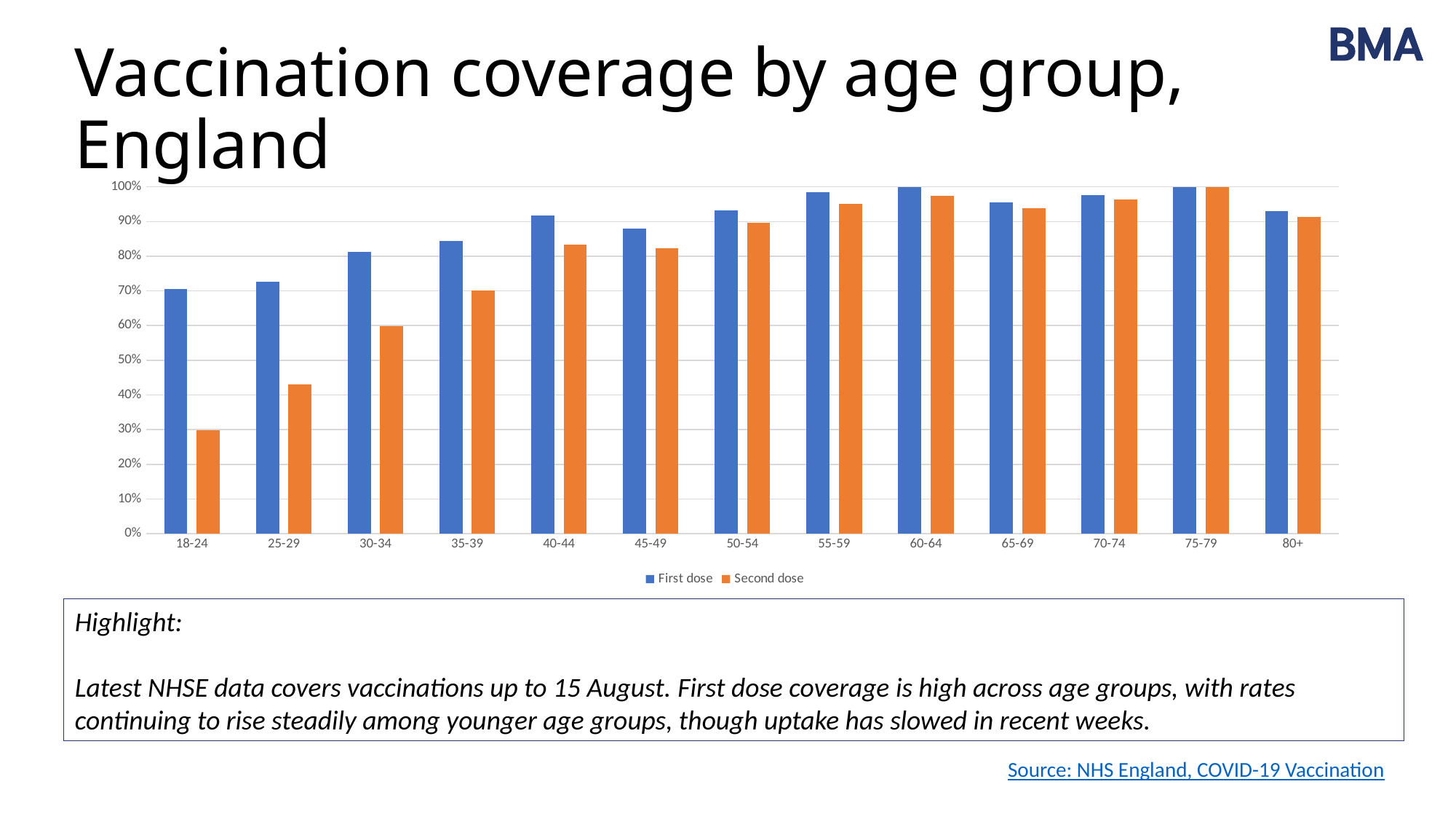
Is the second dose value for 35-39 greater or less than 60%? greater Is the first dose value for 30-34 greater or less than 70%? greater Which age group has the highest second dose coverage? 75-79 Does second dose coverage rise or fall from 18-24 to 40-44? rise Which age group has the lowest second dose coverage? 18-24 How many series does the chart's legend list? 2 Which series is shown in orange in the chart? Second dose Which is larger, the first dose value for 40-44 or for 45-49? 40-44 What kind of chart is shown on the slide? bar chart Is the second dose value for 25-29 greater or less than 50%? less How many age groups are shown on the x axis of the chart? 13